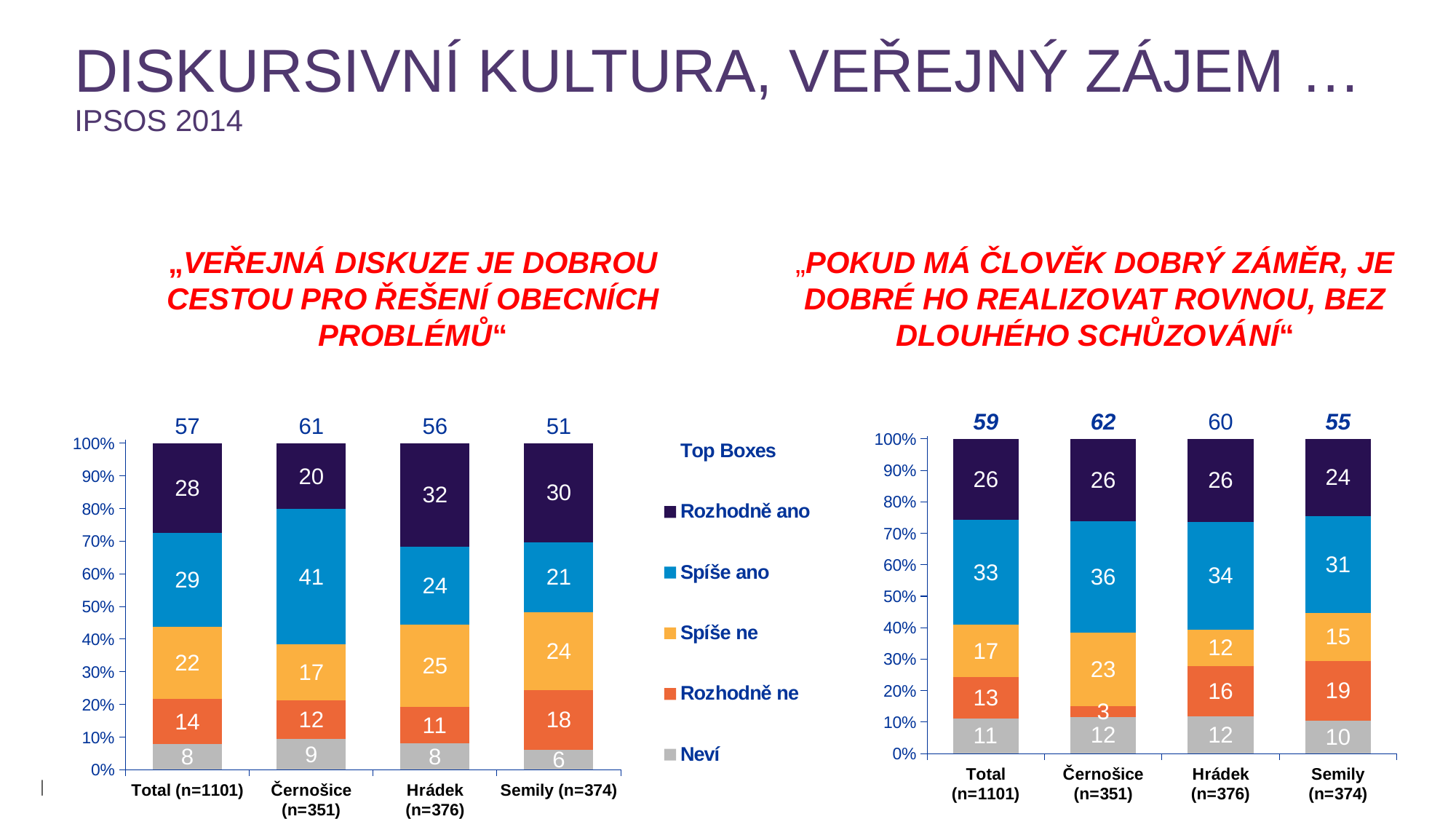
In the right chart ("Pokud má člověk dobrý záměr..."), what is the value of "Spíše ne" for Černošice (n=351)? 23 In the right chart ("Pokud má člověk dobrý záměr..."), which is larger: the "Spíše ano" value for Černošice (n=351) or for Semily (n=374)? Černošice (n=351) In the left chart ("Veřejná diskuze je dobrou cestou pro řešení obecních problémů"), which category has the highest "Rozhodně ano" value? Hrádek (n=376) How many categories are shown on the x axis of the left chart ("Veřejná diskuze je dobrou cestou pro řešení obecních problémů")? 4 In the left chart ("Veřejná diskuze je dobrou cestou pro řešení obecních problémů"), what is the difference between the "Spíše ano" values for Černošice (n=351) and Semily (n=374)? 20 In the left chart ("Veřejná diskuze je dobrou cestou pro řešení obecních problémů"), what is the value of "Spíše ano" for Černošice (n=351)? 41 In the left chart ("Veřejná diskuze je dobrou cestou pro řešení obecních problémů"), what is the total of the "Rozhodně ano" and "Spíše ano" values for Total (n=1101)? 57 In the right chart ("Pokud má člověk dobrý záměr..."), what is the Top Boxes value shown above the Semily (n=374) bar? 55 In the right chart ("Pokud má člověk dobrý záměr..."), which category has the lowest "Rozhodně ne" value? Černošice (n=351) In the left chart ("Veřejná diskuze je dobrou cestou pro řešení obecních problémů"), what is the value of "Rozhodně ne" for Semily (n=374)? 18 What type of chart is the right chart ("Pokud má člověk dobrý záměr...")? Stacked bar chart